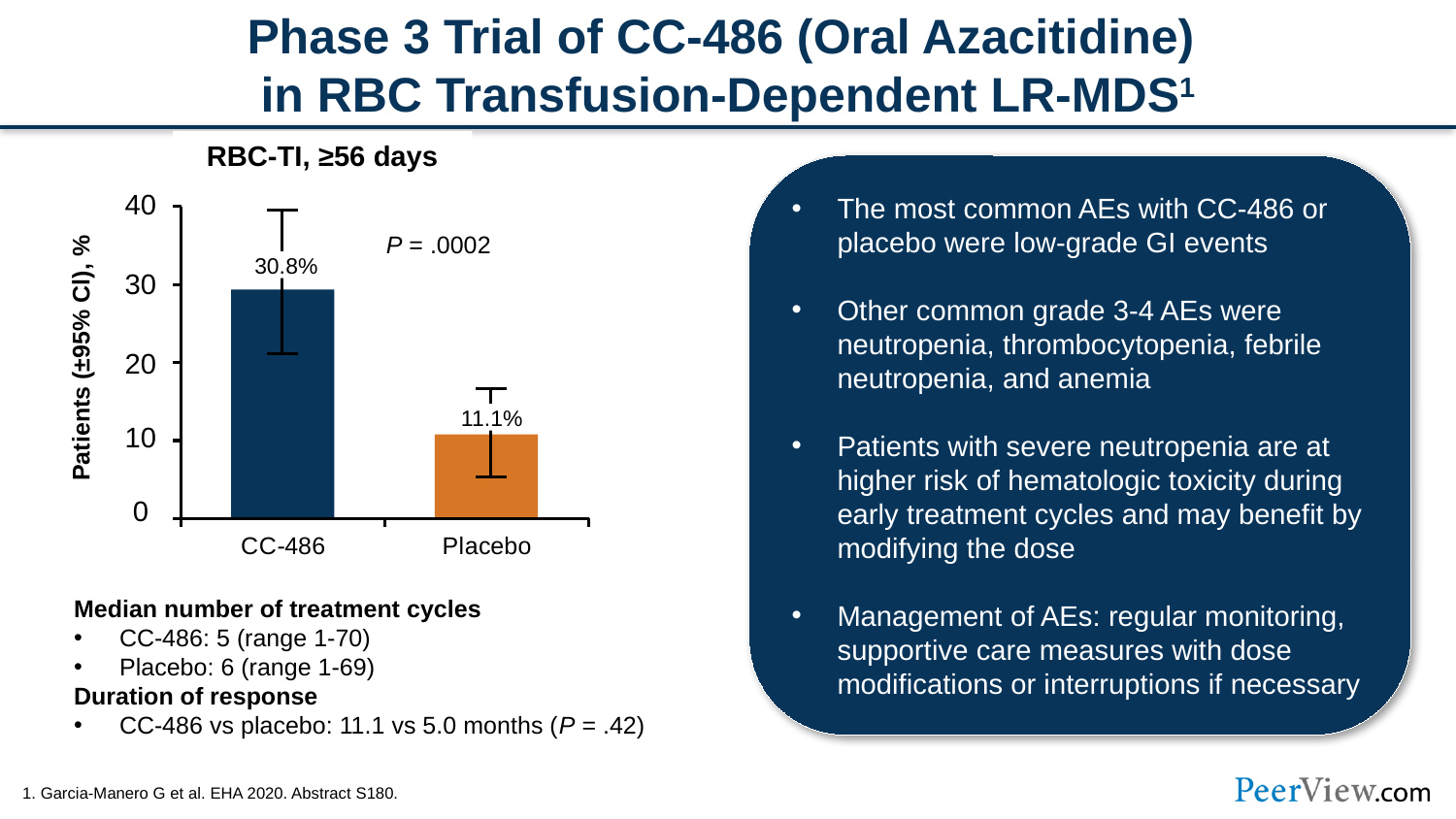
Is the value for Placebo in the RBC-TI, ≥56 days chart greater or less than 20? less Which is larger in the RBC-TI, ≥56 days chart, the value for CC-486 or the value for Placebo? CC-486 What is the title of the chart on the slide? RBC-TI, ≥56 days What P value is shown on the RBC-TI, ≥56 days chart? P = .0002 Which category has the highest value in the RBC-TI, ≥56 days chart? CC-486 What is the value for Placebo in the RBC-TI, ≥56 days chart? 11.1% How many categories are shown in the RBC-TI, ≥56 days chart? 2 What is the difference between the CC-486 and Placebo values in the RBC-TI, ≥56 days chart? 19.7% What kind of chart is the RBC-TI, ≥56 days chart? Bar chart Which category has the lowest value in the RBC-TI, ≥56 days chart? Placebo What is the value for CC-486 in the RBC-TI, ≥56 days chart? 30.8% Is the value for CC-486 in the RBC-TI, ≥56 days chart greater or less than 20? greater